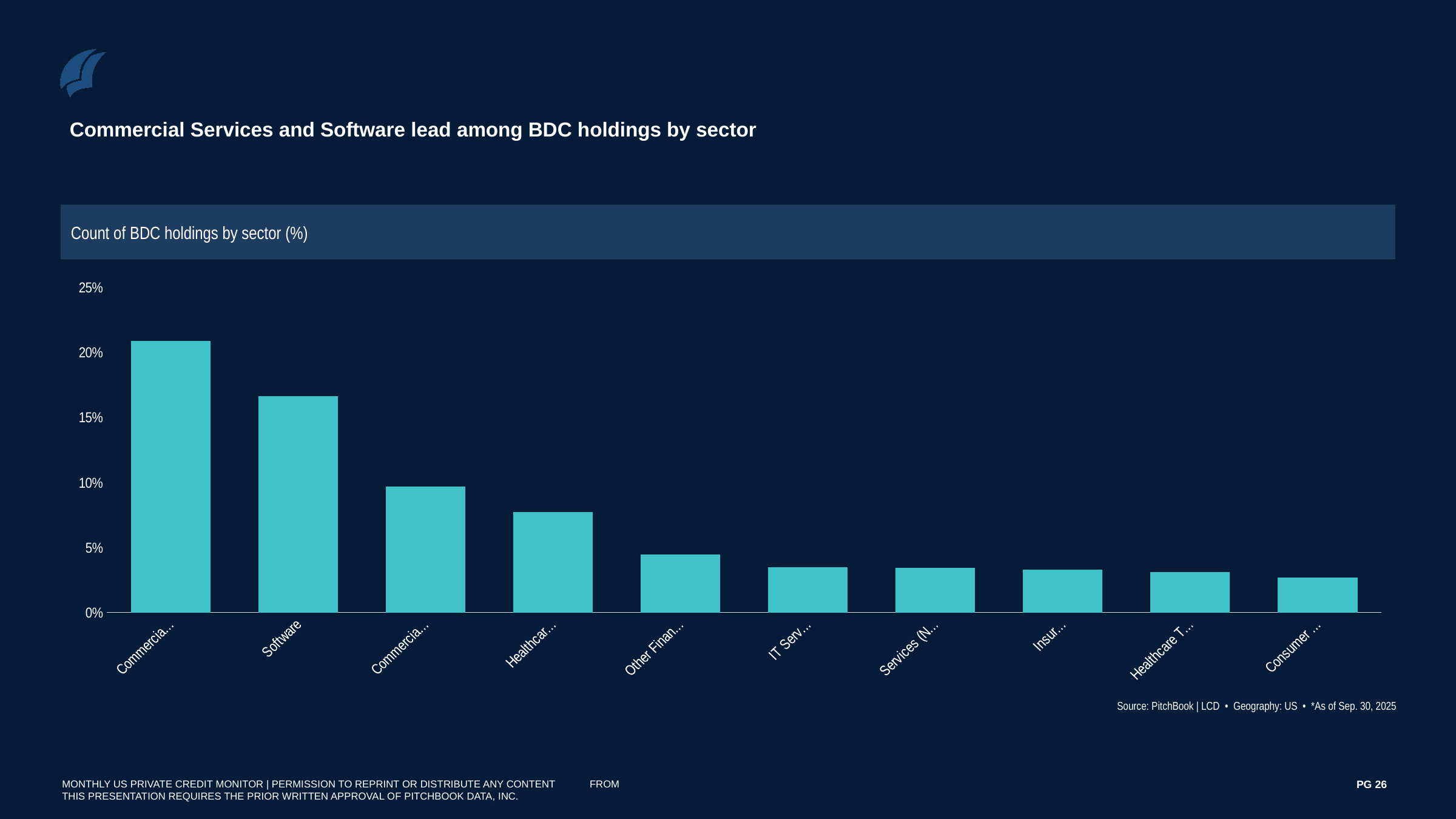
Is the value for the rightmost bar greater or less than 5%? less Is the value for Software greater or less than 15%? greater Which position in the chart does the Software bar occupy from the left? second What is the title of the chart? Count of BDC holdings by sector (%) Is the value for Software greater or less than the value for the leftmost bar? less Do the bar values rise or fall from left to right across the chart? fall Is the value for Software greater or less than 20%? less How many sectors (bars) are plotted in the chart? 10 What is the highest value shown on the y-axis? 25% What kind of chart is shown on the slide? bar chart